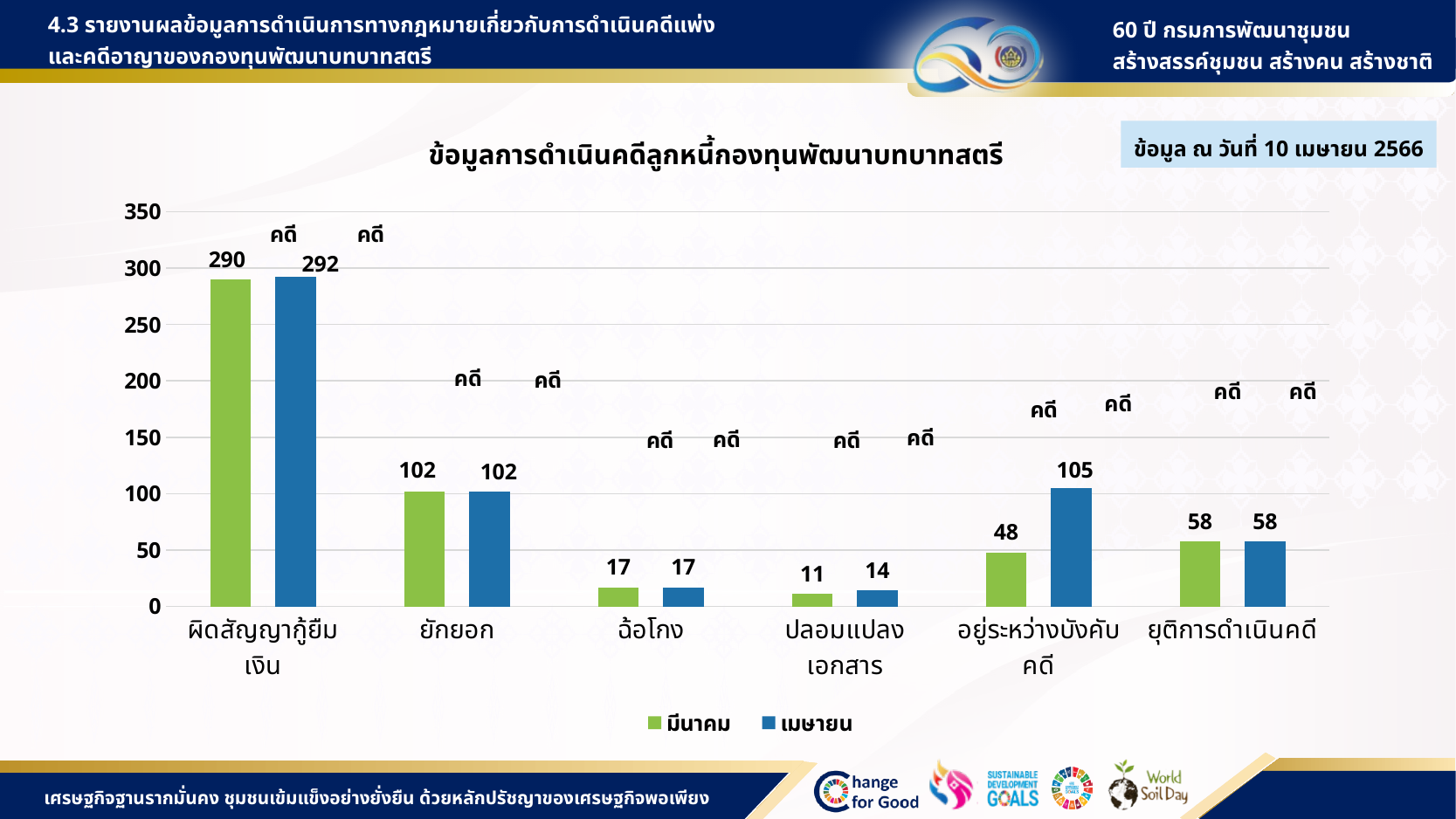
What colour represents the มีนาคม series? green How many series does the legend list? 2 Which category has the lowest value in the มีนาคม series? ปลอมแปลงเอกสาร Which category has the highest value in the เมษายน series? ผิดสัญญากู้ยืมเงิน Is the มีนาคม value for ยักยอก greater or less than 150? less What is the value for ผิดสัญญากู้ยืมเงิน in the มีนาคม series? 290 What kind of chart is shown on the slide? bar chart Which is larger for ปลอมแปลงเอกสาร: the มีนาคม value or the เมษายน value? เมษายน What is the difference between the เมษายน and มีนาคม values for อยู่ระหว่างบังคับคดี? 57 How many categories are shown on the x axis? 6 What is the value for ปลอมแปลงเอกสาร in the เมษายน series? 14 What is the value for อยู่ระหว่างบังคับคดี in the เมษายน series? 105